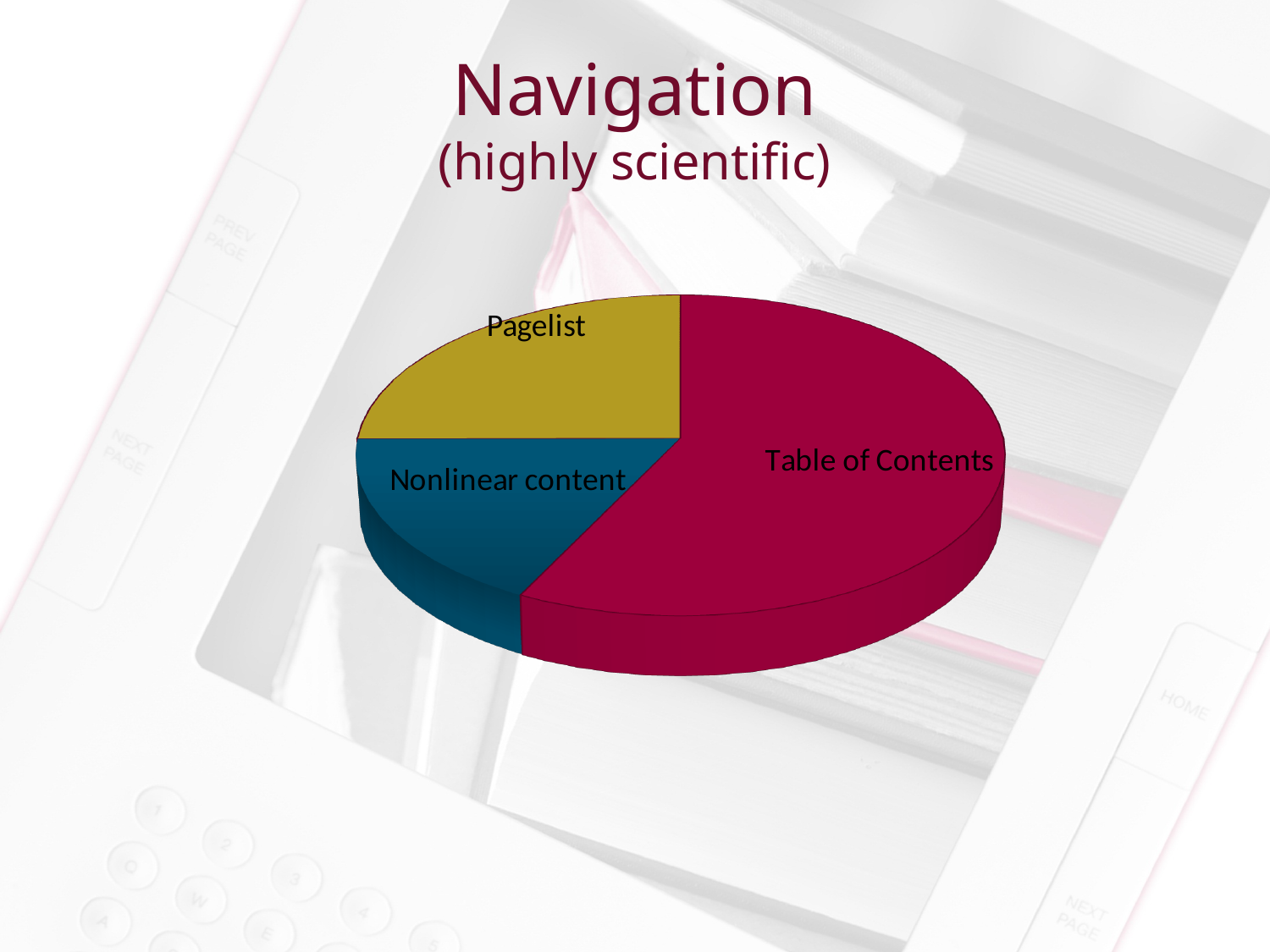
What is the title of the slide containing the pie chart? Navigation (highly scientific) Which slice of the pie chart is the smallest? Nonlinear content How many slices does the pie chart have? 3 What kind of chart is shown on the slide? pie chart Which slice is larger, Pagelist or Nonlinear content? Pagelist What colour is the Table of Contents slice of the pie chart? maroon Which slice of the pie chart is the largest? Table of Contents Which slice is larger, Nonlinear content or Table of Contents? Table of Contents Which slice is larger, Table of Contents or Pagelist? Table of Contents